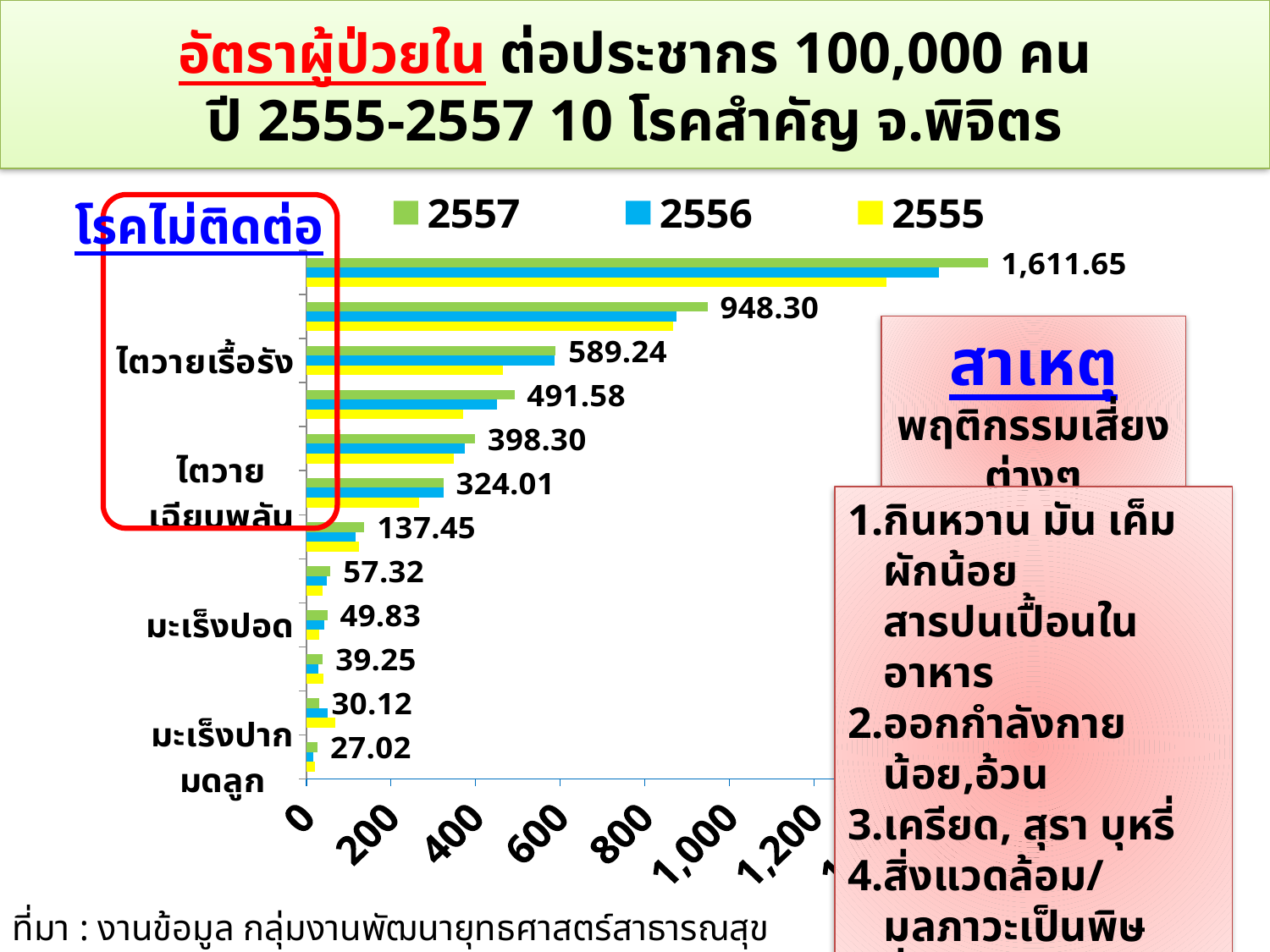
What is the 2557 value for ไตวายเรื้อรัง? 589.24 Is the 2556 value for the top category (the one labelled 1,611.65 for 2557) greater or less than 1,200? greater What is the 2557 value for มะเร็งปากมดลูก? 27.02 How many series does the legend list? 3 What is the difference between the two largest 2557 data labels, 1,611.65 and 948.30? 663.35 What is the lowest data label shown on the chart? 27.02 What is the 2557 value for มะเร็งปอด? 49.83 Which years are listed in the chart legend? 2557, 2556, 2555 What is the highest data label shown on the chart? 1,611.65 Which has the larger 2557 value, ไตวายเรื้อรัง or ไตวายเฉียบพลัน? ไตวายเรื้อรัง What type of chart is shown on the slide? bar chart Do the 2557 values rise or fall moving from the top category to the bottom category? fall